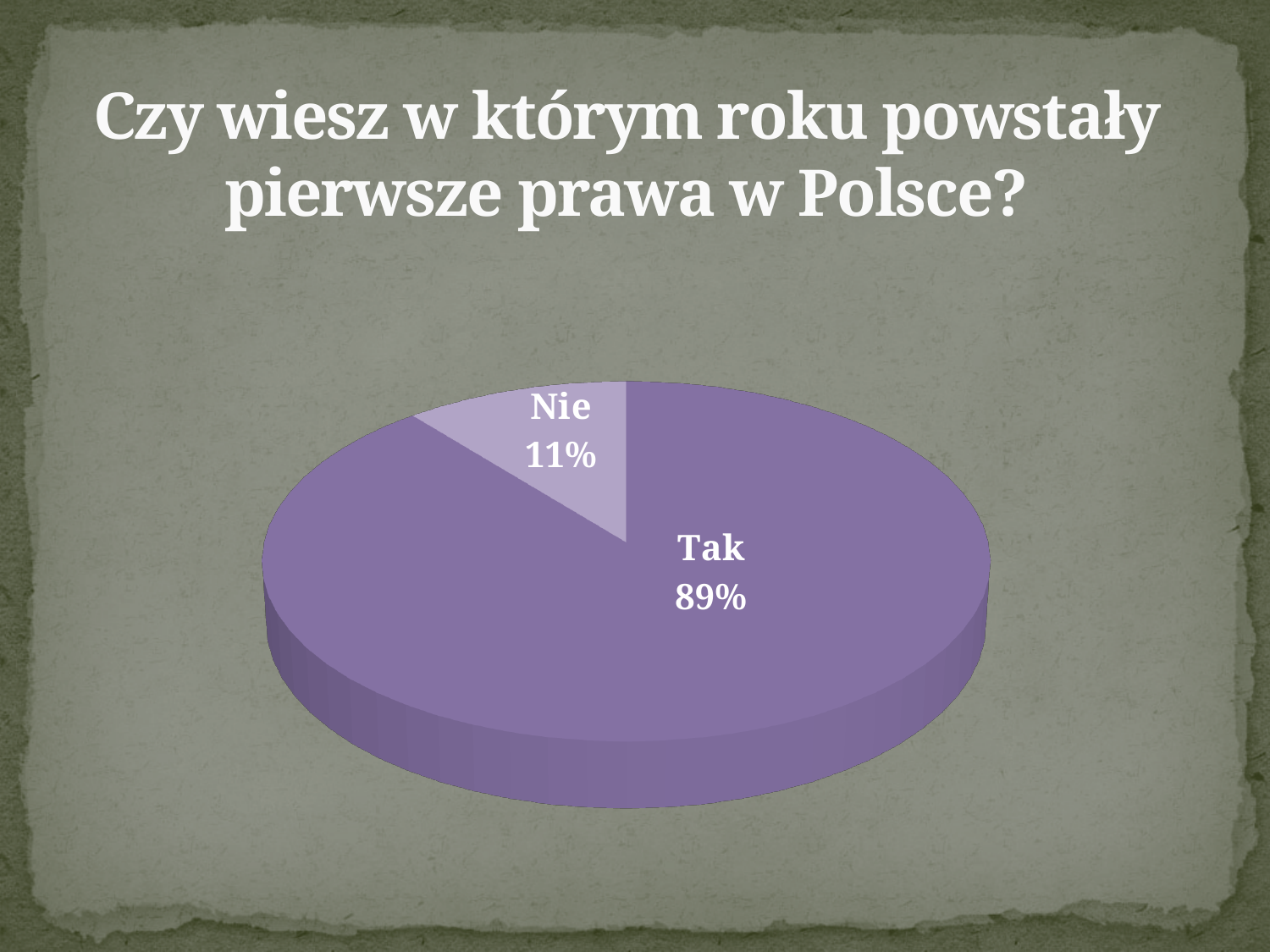
Which slice is the smallest? Nie Which slice is shown in the lighter purple colour? Nie Which slice is the largest? Tak What is the difference in percentage points between "Tak" and "Nie"? 78 What kind of chart is shown on the slide? pie chart What share of the pie does "Nie" take? 11% Which is larger, "Tak" or "Nie"? Tak How many slices does the pie chart have? 2 What is the title of the slide above the chart? Czy wiesz w którym roku powstały pierwsze prawa w Polsce? What share of the pie does "Tak" take? 89%